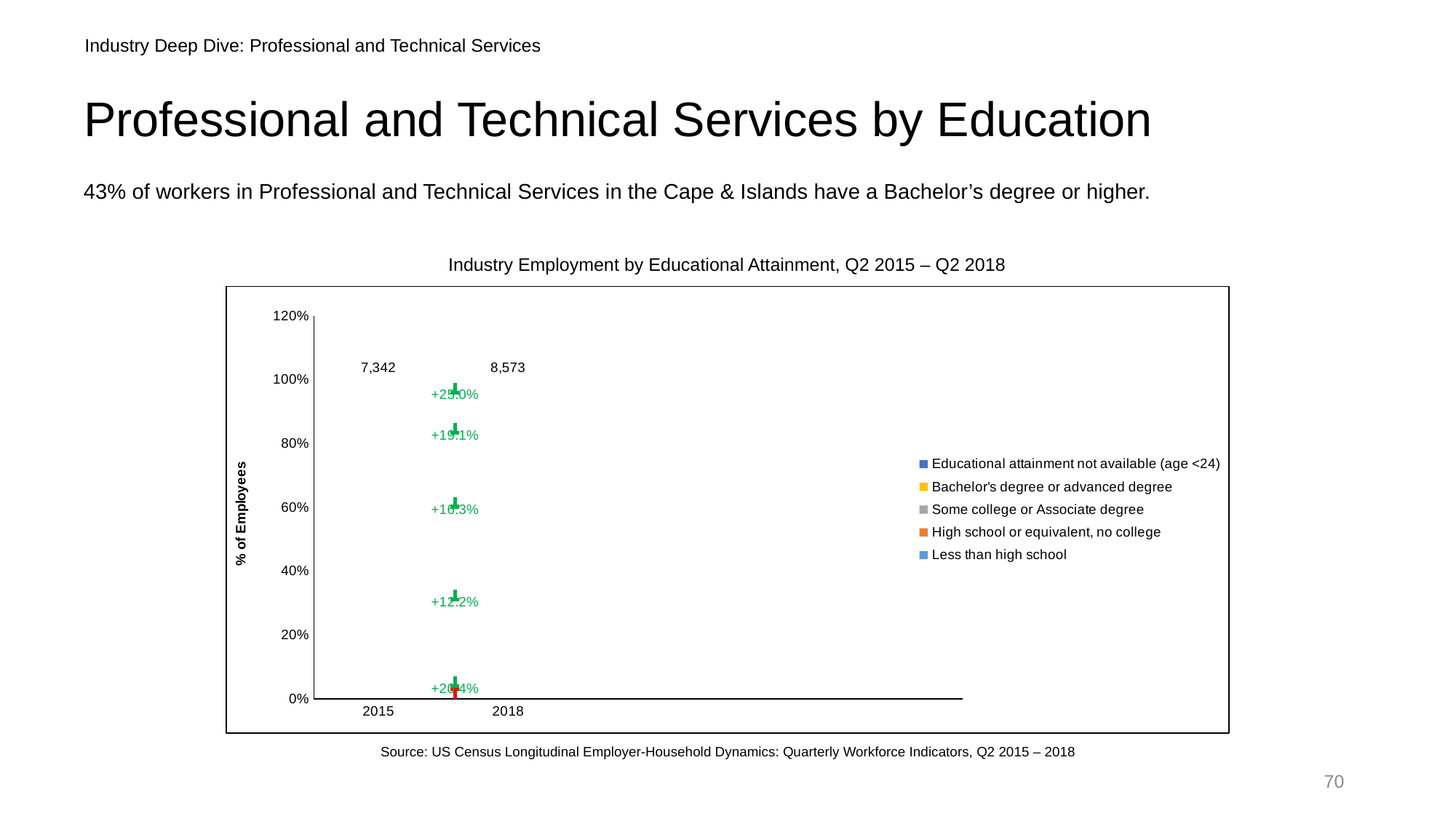
Which year has the larger total employment figure, 2015 or 2018? 2018 What total employment figure is printed above the 2018 column? 8,573 What is the title of the chart? Industry Employment by Educational Attainment, Q2 2015 – Q2 2018 How many percentage change labels are shown between the 2015 and 2018 columns? 5 What is the smallest percentage change label shown between the 2015 and 2018 columns? +12.2% How many series does the chart's legend list? 5 By how much does the 2018 total (8,573) exceed the 2015 total (7,342)? 1,231 What is the largest percentage change label shown between the 2015 and 2018 columns? +25.0% What is the label on the y axis of the chart? % of Employees What total employment figure is printed above the 2015 column? 7,342 How many years are shown on the x axis of the chart? 2 Is the 2015 total employment figure greater or less than 8,000? less